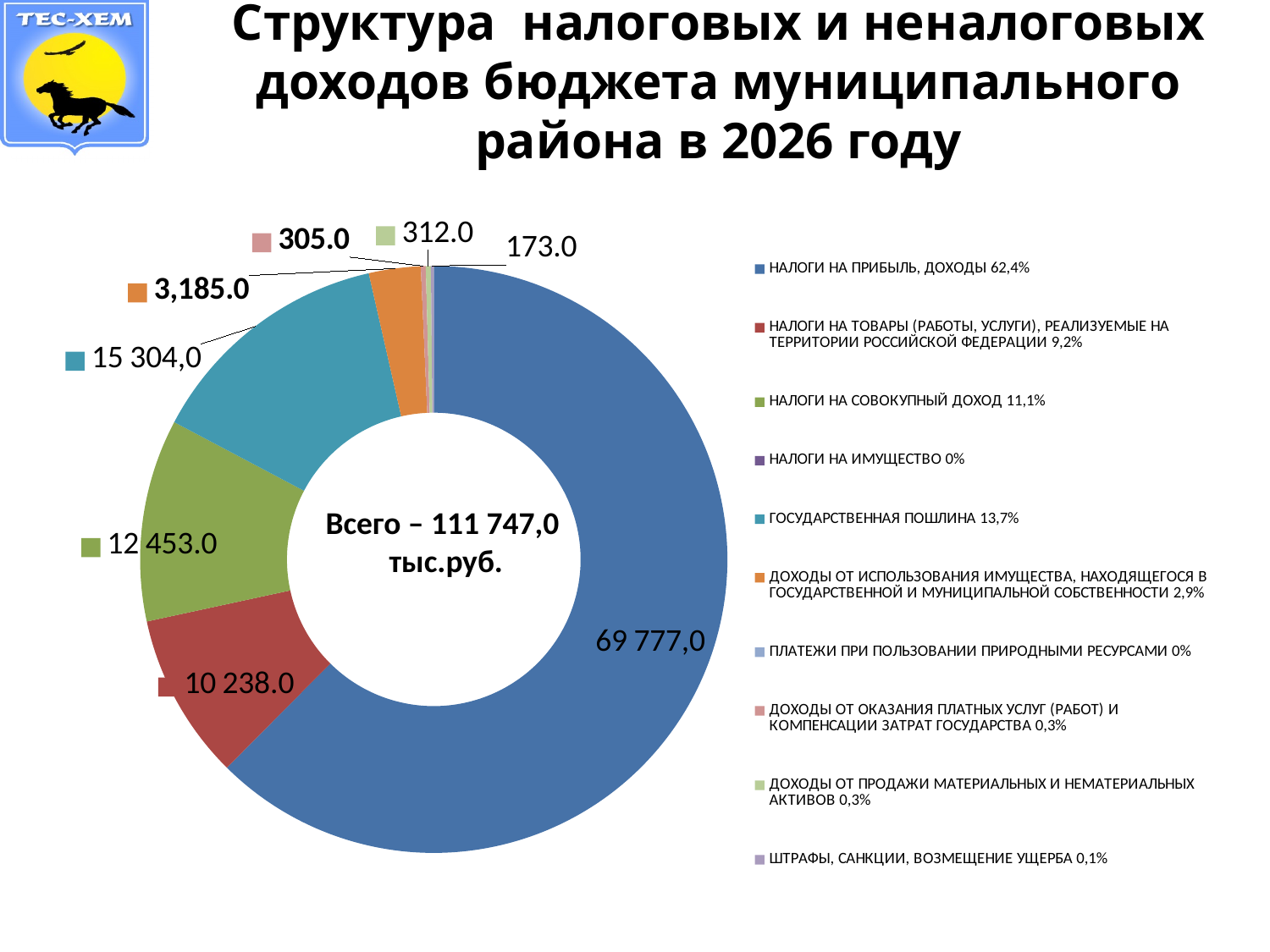
What kind of chart is shown on the slide? Doughnut (pie) chart What is the value for НАЛОГИ НА СОВОКУПНЫЙ ДОХОД? 12 453.0 What is the value for ГОСУДАРСТВЕННАЯ ПОШЛИНА? 15 304,0 What is the value for ДОХОДЫ ОТ ИСПОЛЬЗОВАНИЯ ИМУЩЕСТВА, НАХОДЯЩЕГОСЯ В ГОСУДАРСТВЕННОЙ И МУНИЦИПАЛЬНОЙ СОБСТВЕННОСТИ? 3,185.0 What total is printed in the centre of the chart? Всего – 111 747,0 тыс.руб. What share of the total does НАЛОГИ НА ПРИБЫЛЬ, ДОХОДЫ represent, according to the legend? 62,4% What share of the total does ГОСУДАРСТВЕННАЯ ПОШЛИНА represent, according to the legend? 13,7% How many entries does the legend list? 10 What is the value for НАЛОГИ НА ТОВАРЫ (РАБОТЫ, УСЛУГИ), РЕАЛИЗУЕМЫЕ НА ТЕРРИТОРИИ РОССИЙСКОЙ ФЕДЕРАЦИИ? 10 238.0 Which is larger: the value for ГОСУДАРСТВЕННАЯ ПОШЛИНА or the value for НАЛОГИ НА СОВОКУПНЫЙ ДОХОД? ГОСУДАРСТВЕННАЯ ПОШЛИНА What is the value for НАЛОГИ НА ПРИБЫЛЬ, ДОХОДЫ? 69 777,0 Which category has the largest slice of the chart? НАЛОГИ НА ПРИБЫЛЬ, ДОХОДЫ